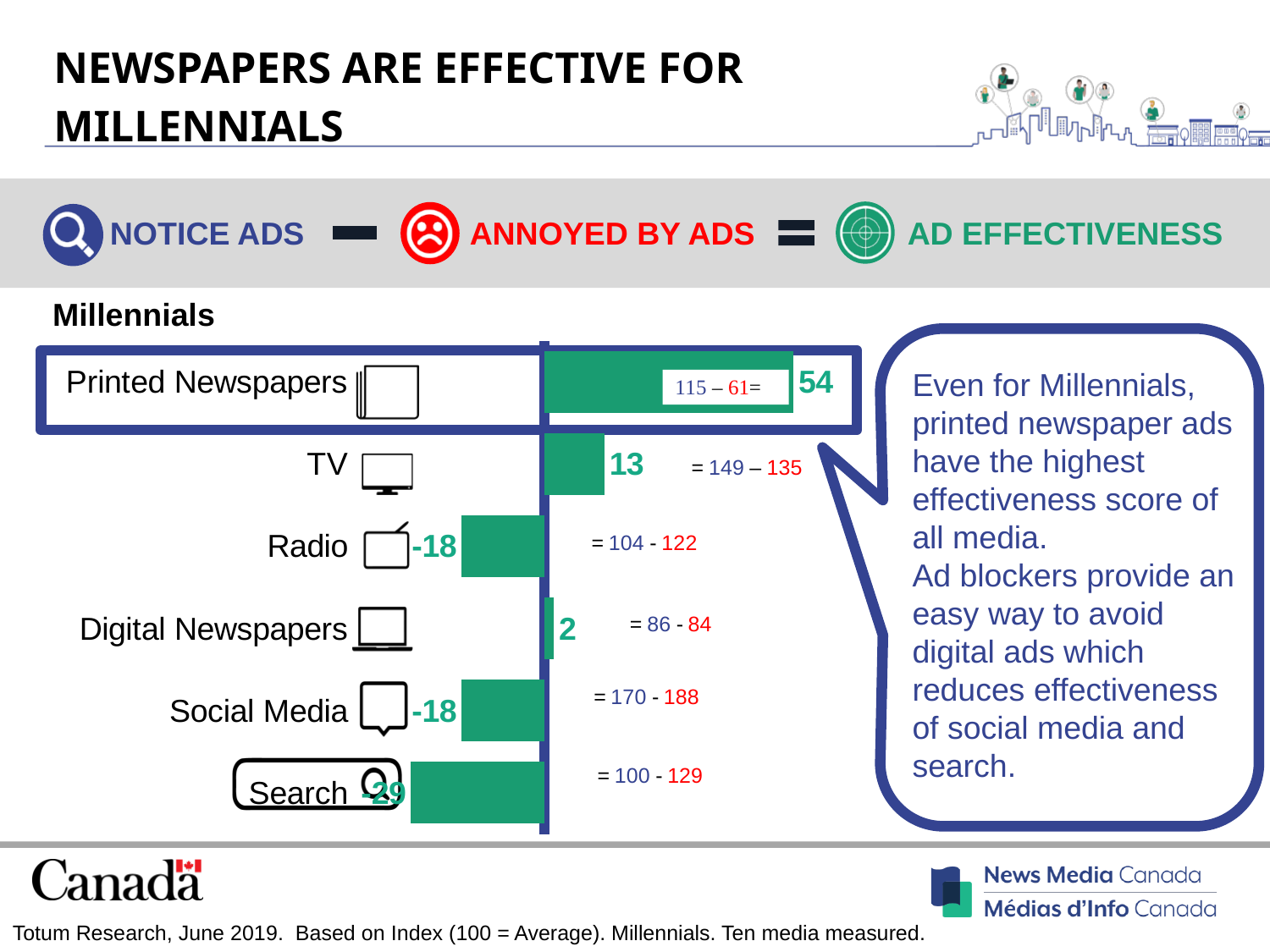
What is the ad effectiveness score for Search? -29 What is the difference between the ad effectiveness scores of Printed Newspapers and TV? 41 How many media are shown in the chart? 6 Which medium has the lowest ad effectiveness score? Search What kind of chart is used to show the ad effectiveness scores? Bar chart What is the ad effectiveness score for Digital Newspapers? 2 What is the 'annoyed by ads' index value for Radio? 122 What is the ad effectiveness score for Printed Newspapers among Millennials? 54 What is the ad effectiveness score for TV? 13 Which medium has the highest ad effectiveness score? Printed Newspapers Which has a higher ad effectiveness score, Radio or Digital Newspapers? Digital Newspapers What is the 'notice ads' index value for Social Media? 170